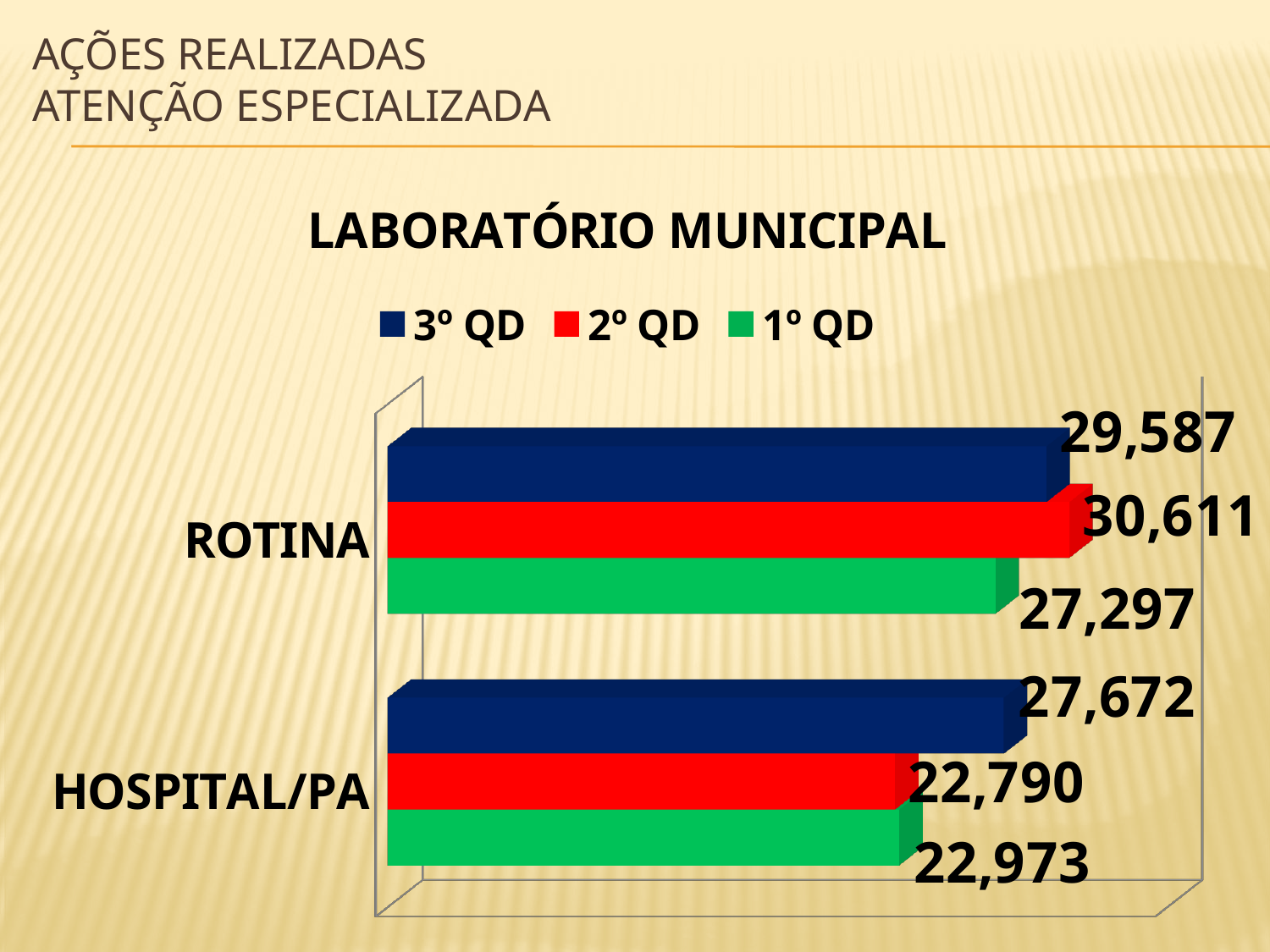
How many categories are shown on the chart? 2 Which series has the highest value for ROTINA? 2º QD Which is larger: the 1º QD value for ROTINA or the 1º QD value for HOSPITAL/PA? ROTINA What type of chart is shown on the slide? Bar chart What is the value for ROTINA in the 2º QD series? 30,611 What is the value for HOSPITAL/PA in the 1º QD series? 22,973 Which series has the lowest value for HOSPITAL/PA? 2º QD How many series does the legend list? 3 What is the value for HOSPITAL/PA in the 3º QD series? 27,672 What is the value for ROTINA in the 3º QD series? 29,587 What is the difference between the 3º QD and 2º QD values for HOSPITAL/PA? 4,882 What is the difference between the 2º QD and 3º QD values for ROTINA? 1,024